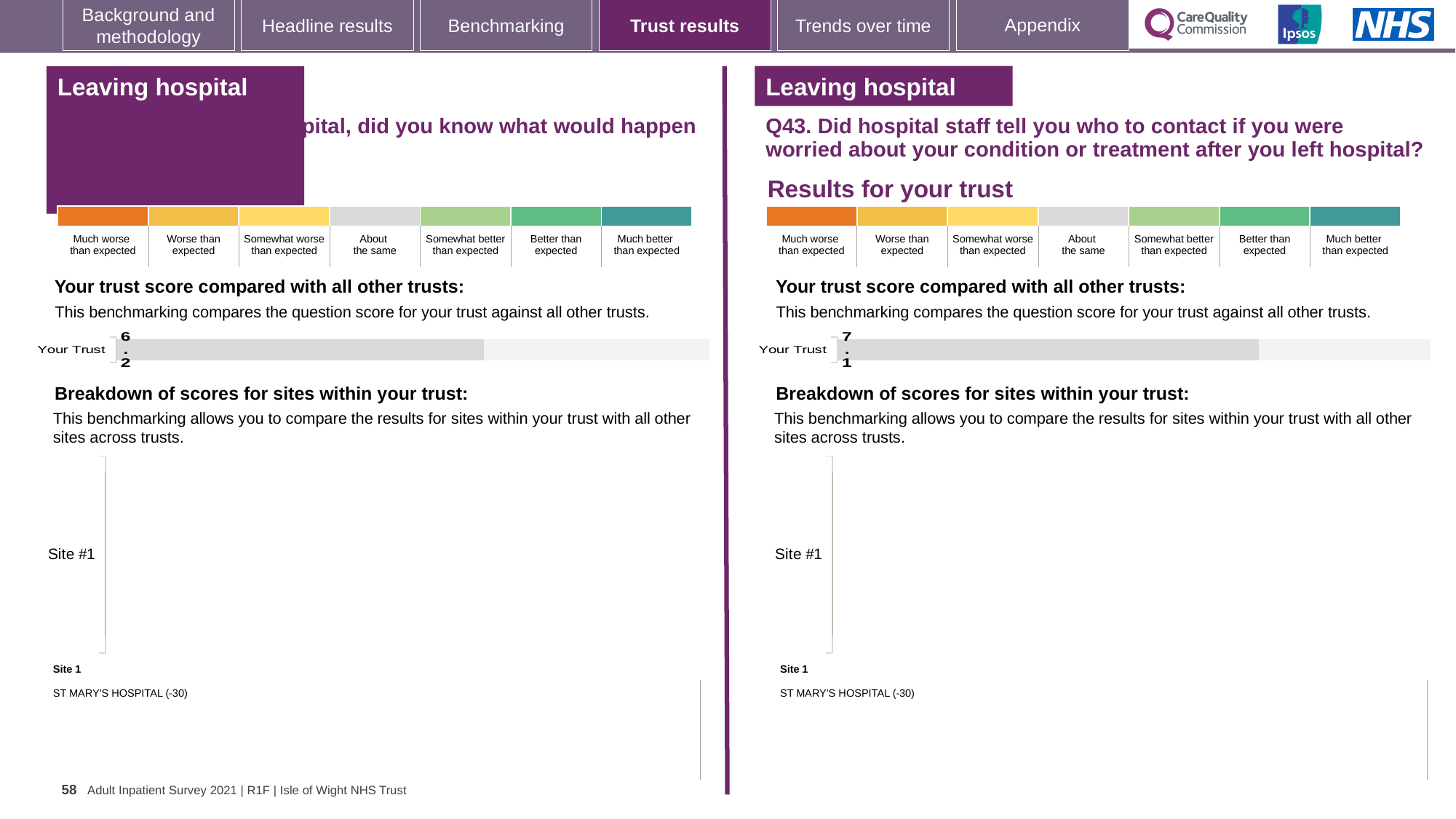
What is the difference between the Your Trust score on the right-hand Q43 chart and the Your Trust score on the left-hand chart? 0.9 On the right-hand chart (Q43), what is the score shown for Your Trust? 7.1 What kind of chart is used to show the Your Trust score on the right-hand Q43 panel? Bar chart On the right-hand Q43 panel, what is the name of Site 1? ST MARY'S HOSPITAL (-30) How many bars are plotted in the 'Your trust score compared with all other trusts' chart on the right-hand Q43 panel? 1 On the left-hand 'Your trust score compared with all other trusts' chart, what is the score shown for Your Trust? 6.2 What is the label of the leftmost (orange) band in the benchmarking scale on the right-hand Q43 panel? Much worse than expected How many colour bands are shown in the benchmarking scale above the right-hand Q43 chart? 7 Which panel shows the higher Your Trust score, the left-hand chart or the right-hand Q43 chart? The right-hand Q43 chart How many sites are listed in the 'Breakdown of scores for sites within your trust' section on the right-hand Q43 panel? 1